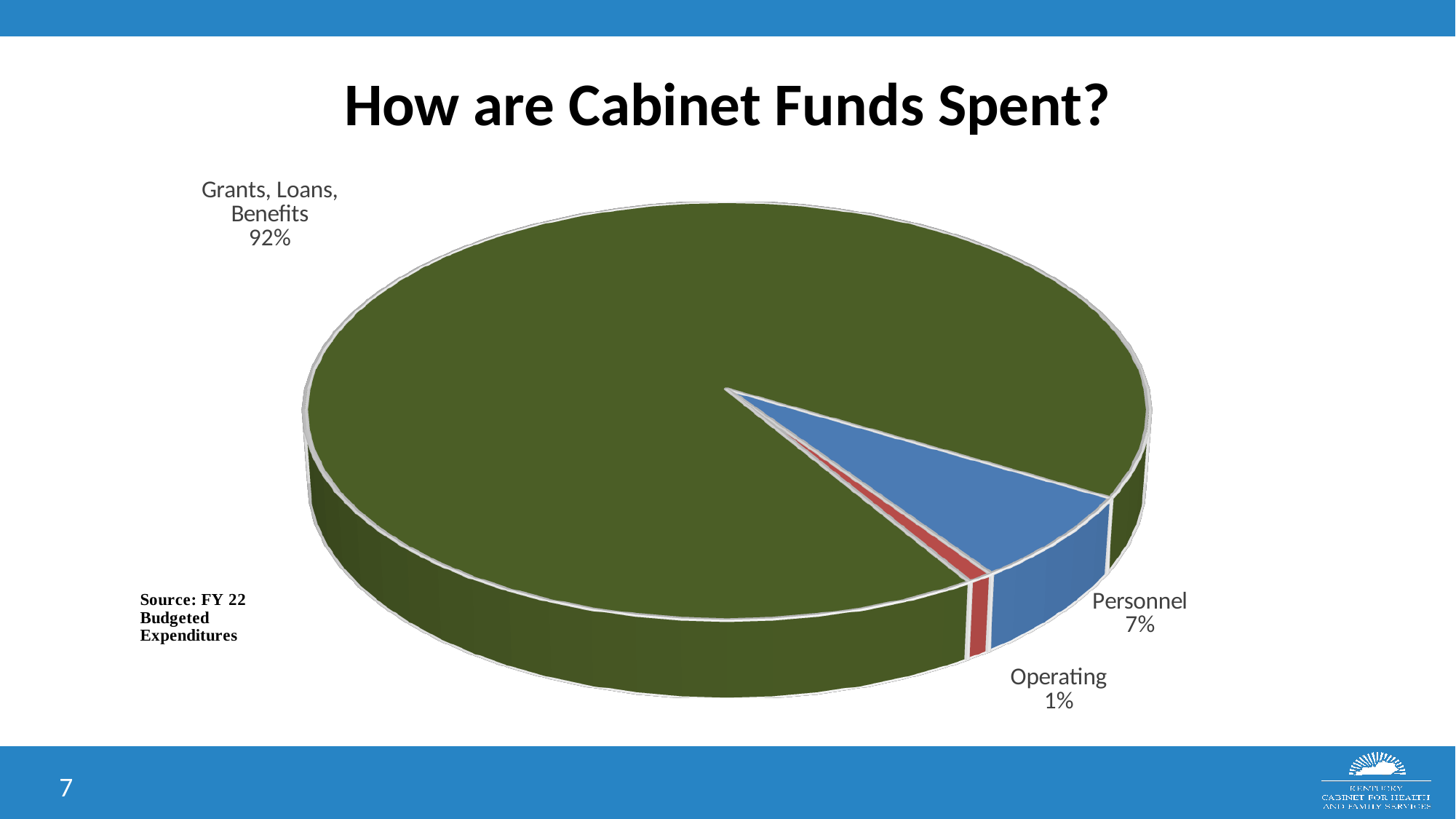
What share of Cabinet funds is spent on Operating? 1% What share of Cabinet funds is spent on Grants, Loans, Benefits? 92% How many categories are shown in the pie chart? 3 Which category accounts for the smallest share of Cabinet funds spent? Operating What is the difference in percentage points between the Grants, Loans, Benefits share and the Personnel share? 85 percentage points Which is larger, the share for Personnel or the share for Operating? Personnel What kind of chart is shown on the slide? Pie chart What is the title of the chart? How are Cabinet Funds Spent? What share of Cabinet funds is spent on Personnel? 7% What is the difference in percentage points between the Personnel share and the Operating share? 6 percentage points What colour is the Personnel slice of the pie chart? Blue Which category accounts for the largest share of Cabinet funds spent? Grants, Loans, Benefits